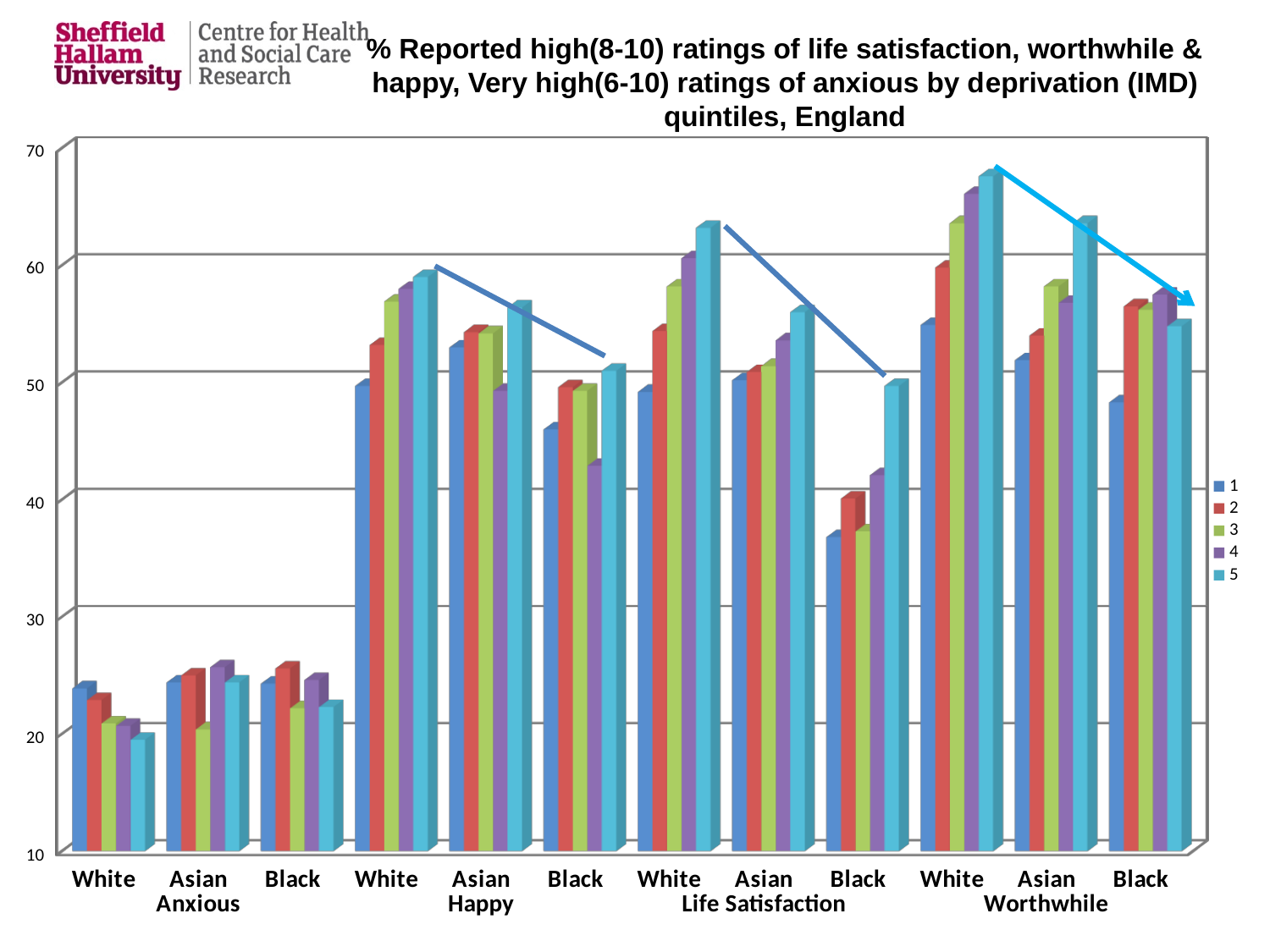
Is the value for series 5 for White under Worthwhile greater or less than 60? greater What kind of chart is shown on the slide? Bar chart How many series does the legend list? 5 Is the value for series 1 for White under Anxious greater or less than 20? greater How many categories are shown along the x axis? 12 Which category and series has the tallest bar in the chart? White under Worthwhile, series 5 Which is larger: series 1 for White under Life Satisfaction or series 1 for Black under Life Satisfaction? White under Life Satisfaction What are the entries listed in the legend? 1, 2, 3, 4, 5 Is the value for series 1 for Black under Life Satisfaction greater or less than 40? less Within the Life Satisfaction group, which ethnic group has the lowest values? Black For White under Worthwhile, do the values rise or fall from series 1 to series 5? rise